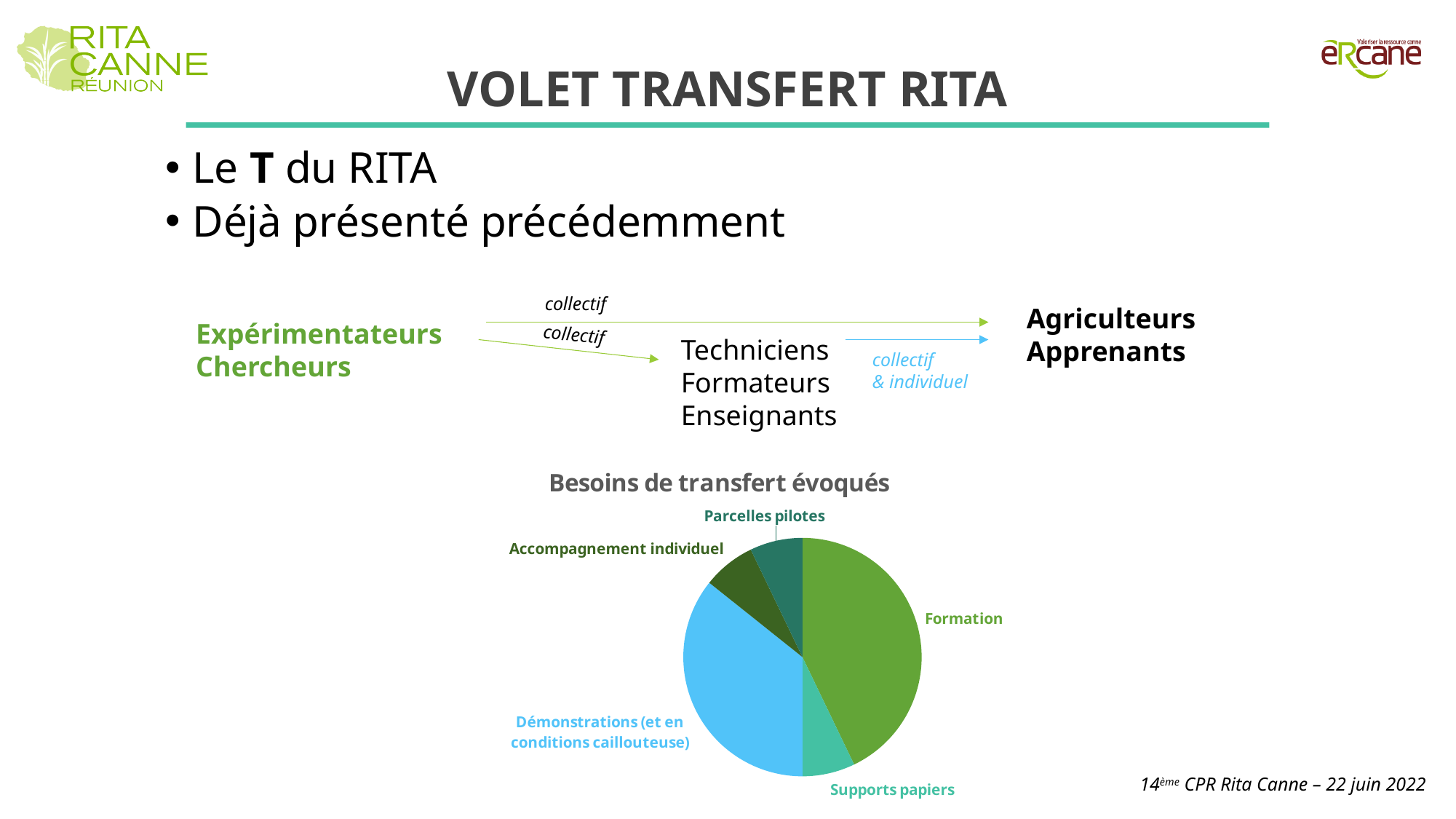
In the pie chart "Besoins de transfert évoqués", what colour is the Démonstrations (et en conditions caillouteuse) slice? light blue In the pie chart "Besoins de transfert évoqués", which slice is larger: Démonstrations (et en conditions caillouteuse) or Accompagnement individuel? Démonstrations (et en conditions caillouteuse) In the pie chart "Besoins de transfert évoqués", which slice is larger: Démonstrations (et en conditions caillouteuse) or Parcelles pilotes? Démonstrations (et en conditions caillouteuse) Which category has the largest slice in the pie chart "Besoins de transfert évoqués"? Formation What kind of chart is shown under the heading "Besoins de transfert évoqués"? pie chart What is the title of the pie chart on the slide? Besoins de transfert évoqués How many slices does the pie chart "Besoins de transfert évoqués" have? 5 In the pie chart "Besoins de transfert évoqués", which slice is larger: Formation or Supports papiers? Formation